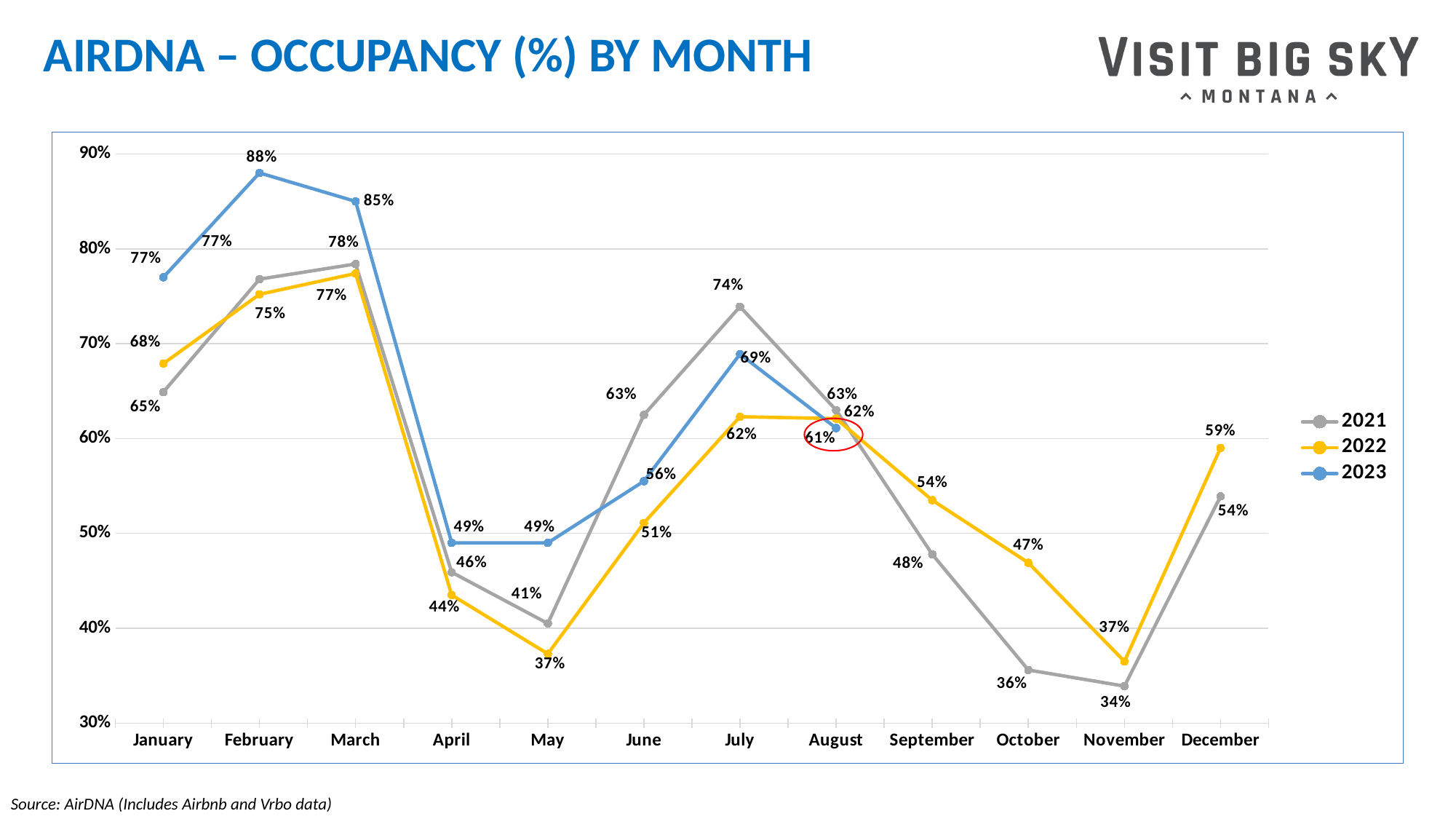
What was the occupancy for 2023 in August? 61% What was the occupancy for 2023 in February? 88% What is the difference between the 2021 and 2022 occupancy in July? 12 percentage points Which month has the highest occupancy for the 2023 series? February How many series does the legend list? 3 What kind of chart is shown on the slide? Line chart In October, which series has the higher occupancy, 2021 or 2022? 2022 Does the 2021 occupancy rise or fall from September to November? Fall Which month has the lowest occupancy for the 2021 series? November How many months are shown on the x axis? 12 What was the occupancy for 2022 in December? 59% Which data point on the chart is circled in red? 2023 August (61%)